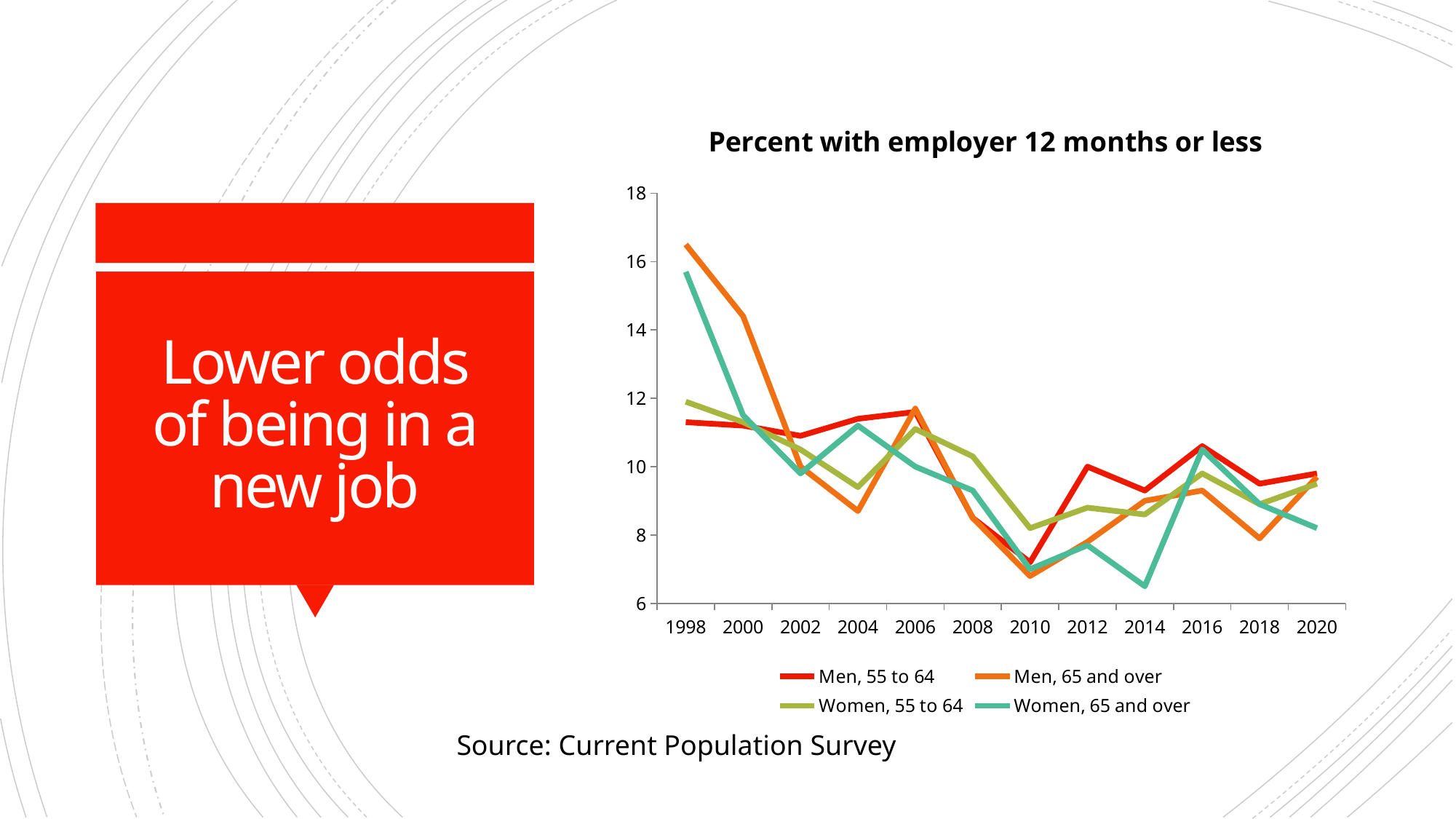
In 2020, which is larger: the value for Men, 55 to 64 or the value for Women, 65 and over? Men, 55 to 64 Is the value for Men, 65 and over in 1998 greater or less than 16? greater How many years are labelled along the x axis? 12 Does the Men, 65 and over series rise or fall from 1998 to 2010? fall What is the title of the chart? Percent with employer 12 months or less Is the value for Women, 65 and over in 2014 greater or less than 8? less Is the value for Men, 55 to 64 in 2012 greater or less than 8? greater How many series does the legend list? 4 Which series has the highest value in 1998? Men, 65 and over What kind of chart is shown on the slide? line chart What source is cited for the chart? Current Population Survey Which series has the lowest value in 2014? Women, 65 and over